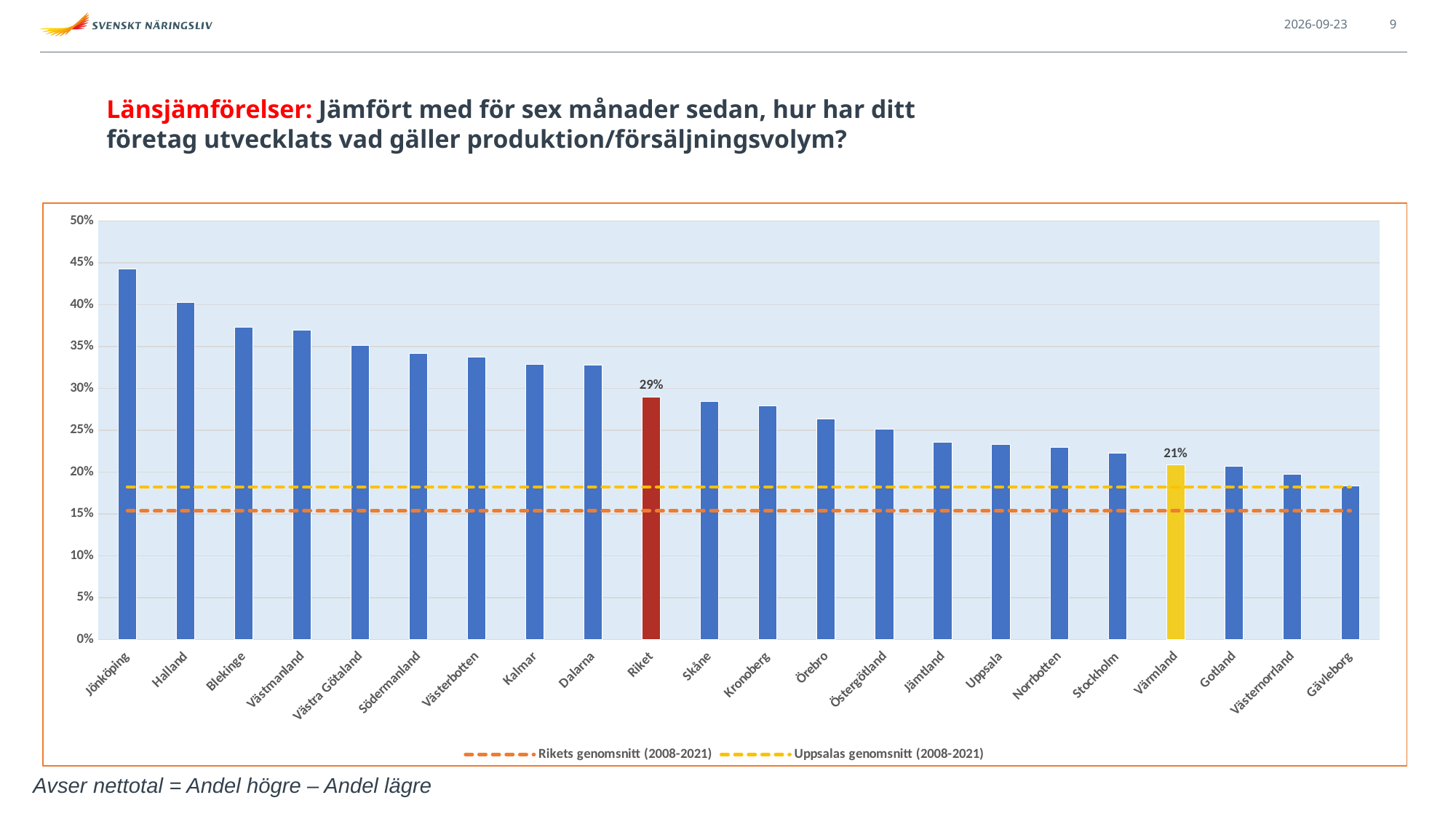
What is the difference between the values for Riket and Värmland? 8 percentage points How many bars are plotted in the chart? 22 Is the value for Gävleborg greater or less than 20%? less How many entries does the legend list? 2 Which county has the highest value? Jönköping Is the value for Jönköping greater or less than 40%? greater What is the value for Riket? 29% Do the bar values rise or fall from left to right along the x axis? Fall Which county has the lowest value? Gävleborg What type of chart is shown on the slide? Bar chart What is the value for Värmland? 21% Which is larger, the value for Jönköping or the value for Halland? Jönköping